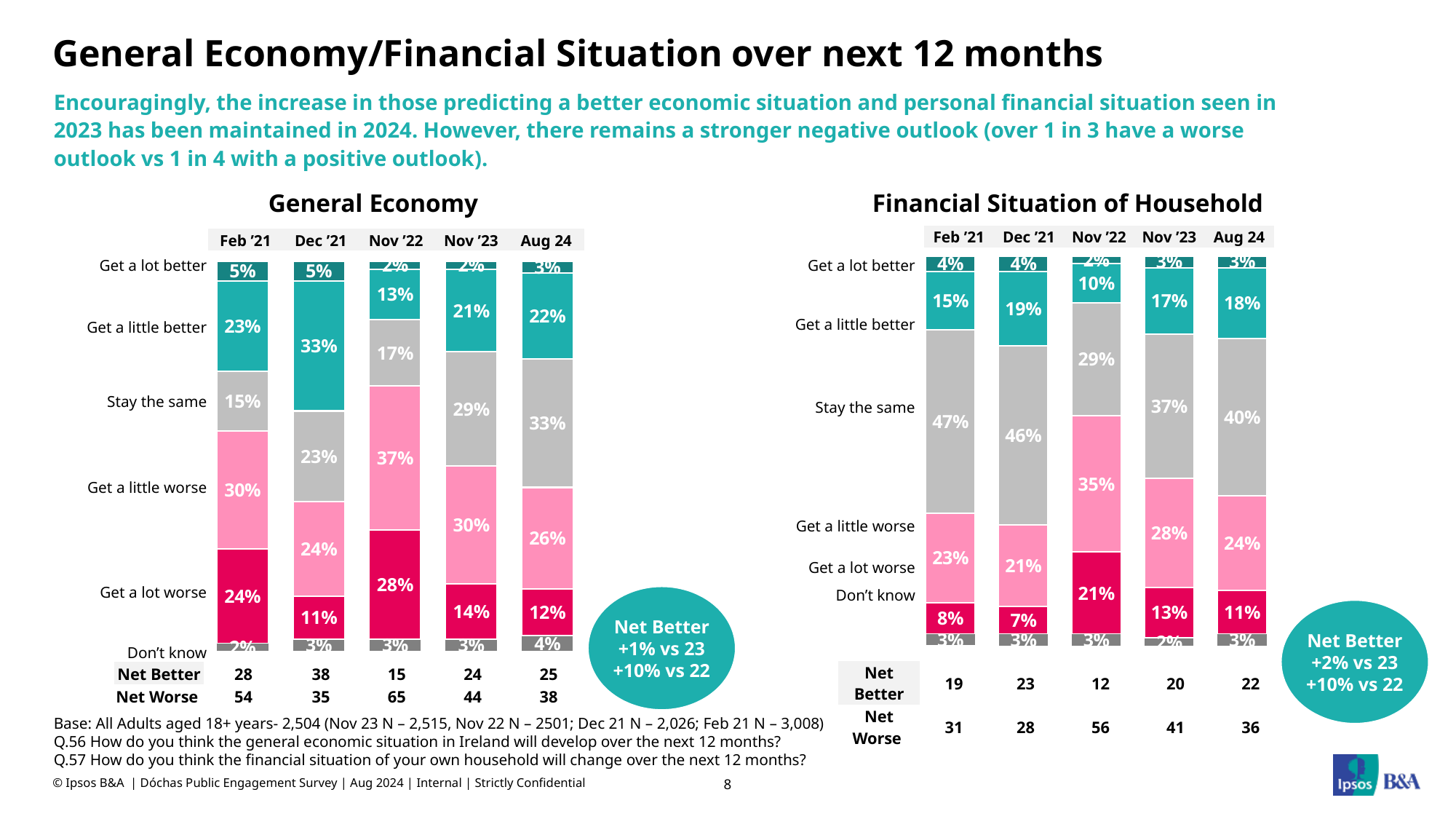
In the General Economy chart, which survey wave has the highest 'Get a little better' percentage? Dec '21 In the Financial Situation of Household chart, what percentage said 'Stay the same' in Feb '21? 47% In the General Economy chart, what is the difference between the 'Stay the same' percentages for Aug 24 and Feb '21? 18% What type of chart is used for General Economy? Stacked bar chart In the Financial Situation of Household chart, what is the Net Worse figure for Nov '22? 56 How many survey waves are shown in the Financial Situation of Household chart? 5 In the Financial Situation of Household chart, which survey wave has the lowest Net Better figure? Nov '22 In the General Economy chart, what percentage said 'Get a lot worse' in Nov '22? 28% In the Financial Situation of Household chart, what is the difference between the Net Worse figures for Nov '22 and Aug 24? 20 In the General Economy chart, what percentage said the economy would 'Get a little better' in Aug 24? 22% In the General Economy chart, which is larger: the 'Get a little worse' percentage in Nov '22 or in Aug 24? Nov '22 In the General Economy chart, what does the circle callout say about Net Better versus 22? +10% vs 22